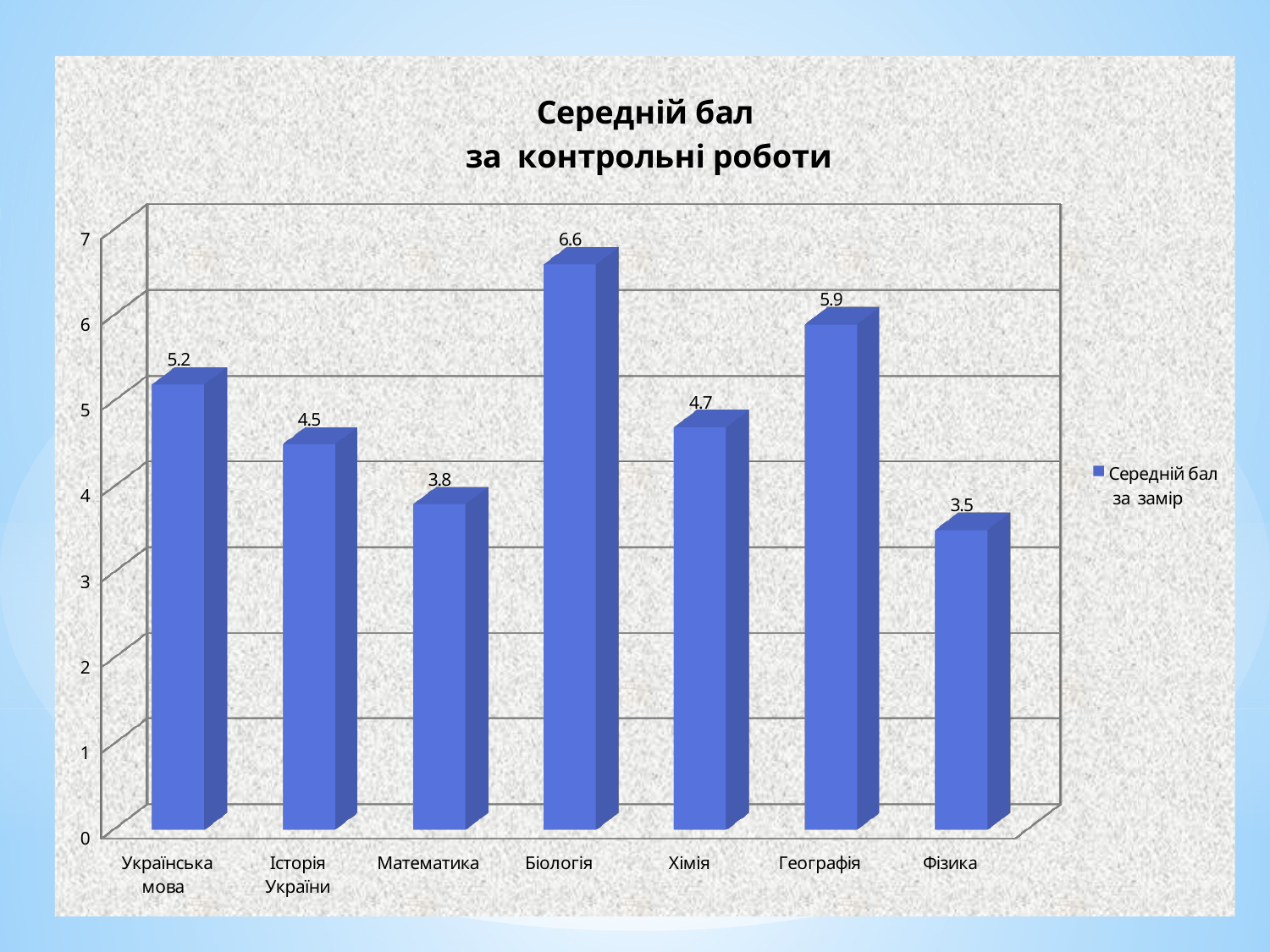
What kind of chart is shown on the slide? bar chart Which has a higher average score, Хімія or Географія? Географія Which subject has the lowest average score? Фізика Is the value for Українська мова greater or less than 5? greater What is the difference between the average scores for Українська мова and Історія України? 0.7 What is the difference between the average scores for Біологія and Фізика? 3.1 What is the average score for Біологія? 6.6 How many subjects are shown on the chart? 7 Which subject has the highest average score? Біологія What is the average score for Математика? 3.8 What is the average score for Географія? 5.9 What is the title of the chart? Середній бал за контрольні роботи